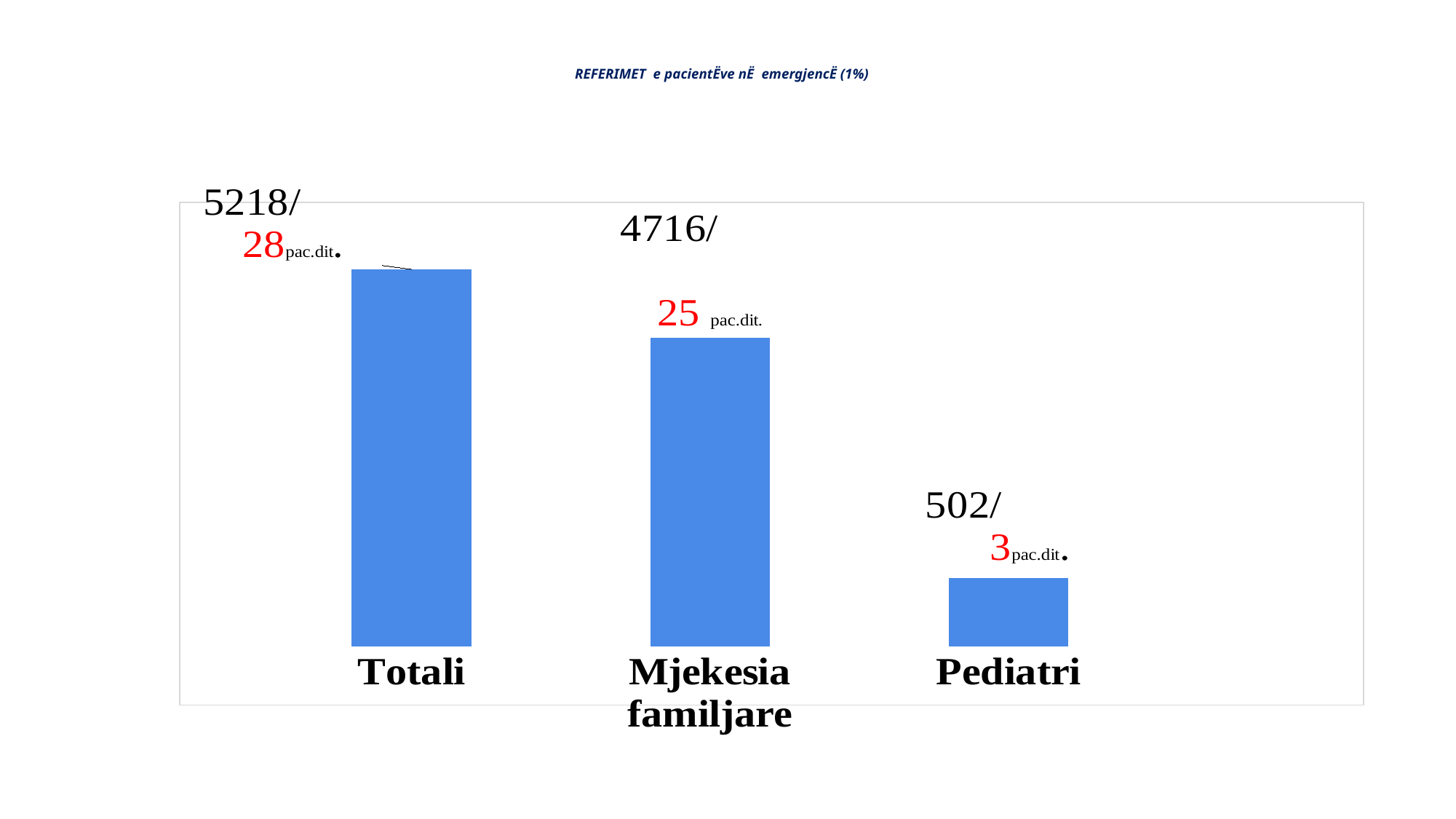
What total value is labelled above the Mjekesia familjare bar? 4716 Which category has the highest bar? Totali How many patients per day (pac.dit.) are labelled for Totali? 28 What total value is labelled above the Pediatri bar? 502 What is the difference between the total values for Mjekesia familjare and Pediatri? 4214 What kind of chart is shown on the slide? bar chart What is the title of the chart? REFERIMET e pacientËve nË emergjencË (1%) Which category has the lowest bar? Pediatri How many patients per day (pac.dit.) are labelled for Pediatri? 3 How many bars does the chart have? 3 How many patients per day (pac.dit.) are labelled for Mjekesia familjare? 25 What total value is labelled above the Totali bar? 5218